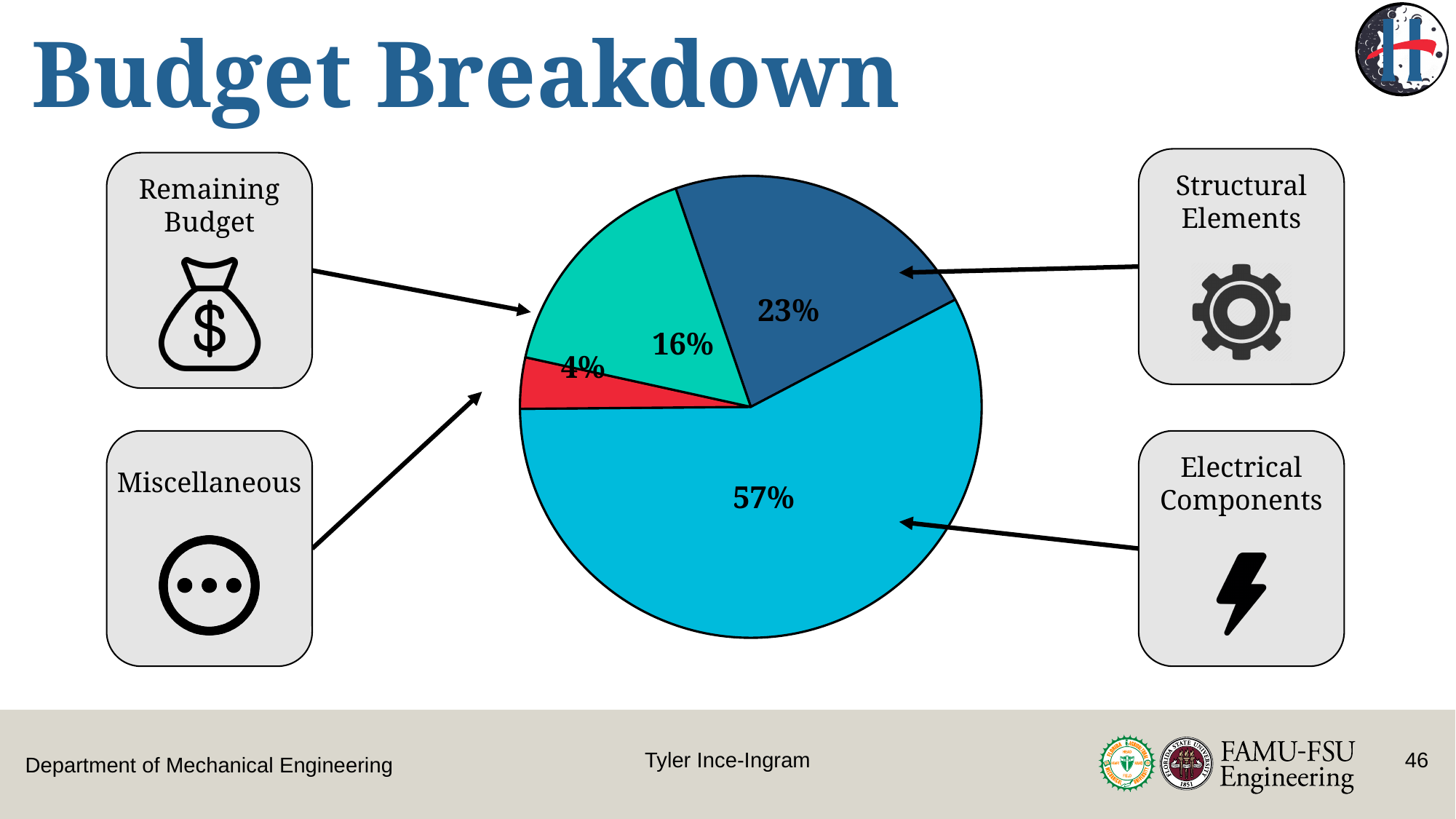
What share of the budget goes to Structural Elements? 23% What is the title of the slide containing the pie chart? Budget Breakdown What share of the budget goes to Electrical Components? 57% What share of the budget is Miscellaneous? 4% How many slices does the pie chart have? 4 What share of the budget is the Remaining Budget? 16% What kind of chart is shown on the slide? pie chart Which is larger, the Structural Elements slice or the Remaining Budget slice? Structural Elements What colour is the Miscellaneous slice of the pie? red Which category has the largest slice of the pie? Electrical Components What is the difference in percentage points between Electrical Components and Structural Elements? 34 Which category has the smallest slice of the pie? Miscellaneous